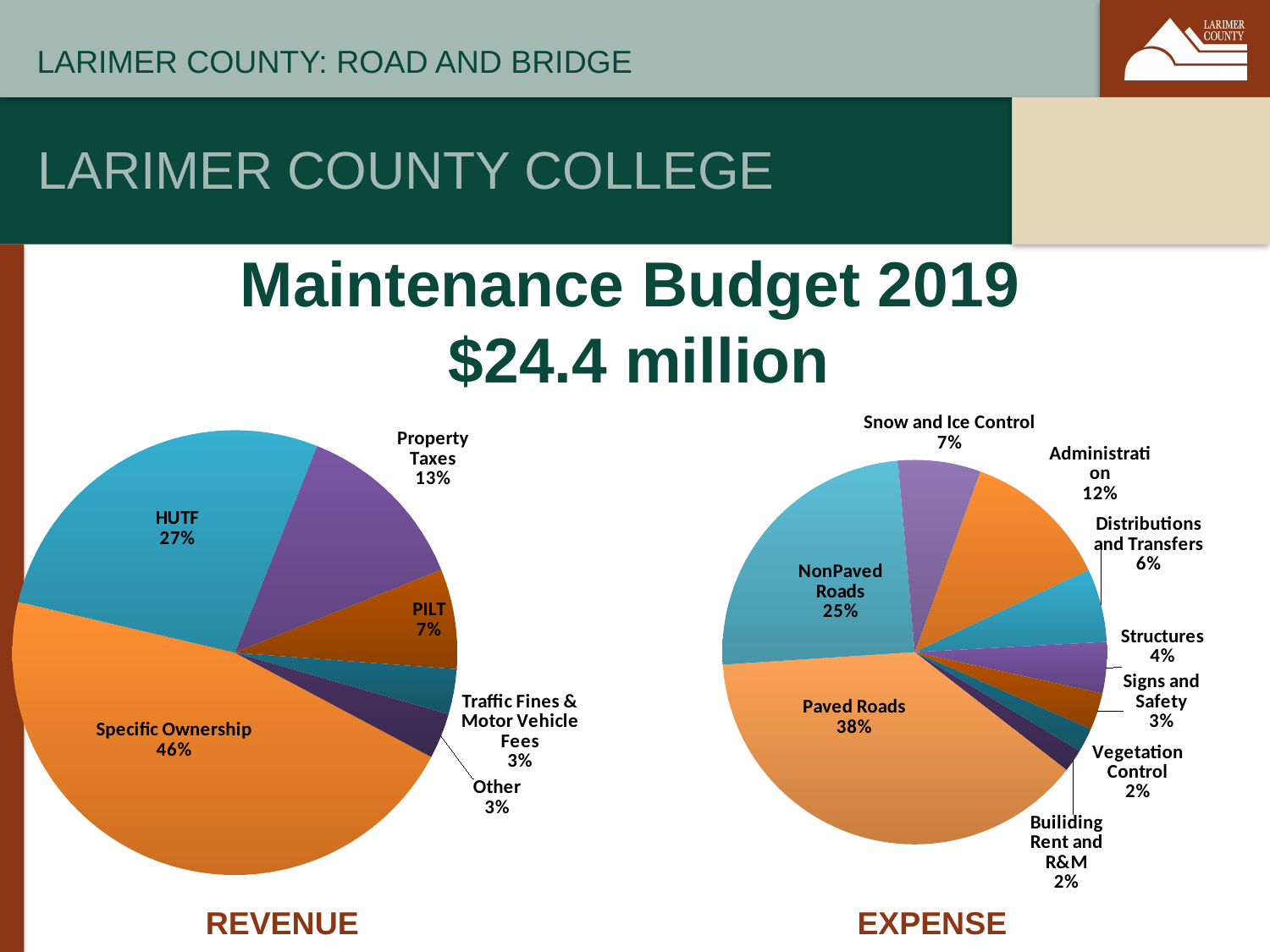
In the EXPENSE chart, what is the difference between the Paved Roads share and the NonPaved Roads share? 13% In the REVENUE chart, which category has the largest share? Specific Ownership What type of chart is the REVENUE chart? Pie chart In the EXPENSE chart, what share does Administration have? 12% In the REVENUE chart, how many slices are there? 6 In the REVENUE chart, what share does HUTF have? 27% In the REVENUE chart, what share does Specific Ownership have? 46% In the REVENUE chart, what is the difference between the Property Taxes share and the PILT share? 6% In the EXPENSE chart, which is larger, Snow and Ice Control or Distributions and Transfers? Snow and Ice Control In the EXPENSE chart, what share does Paved Roads have? 38% In the EXPENSE chart, how many slices are there? 9 In the EXPENSE chart, which category has the largest share? Paved Roads